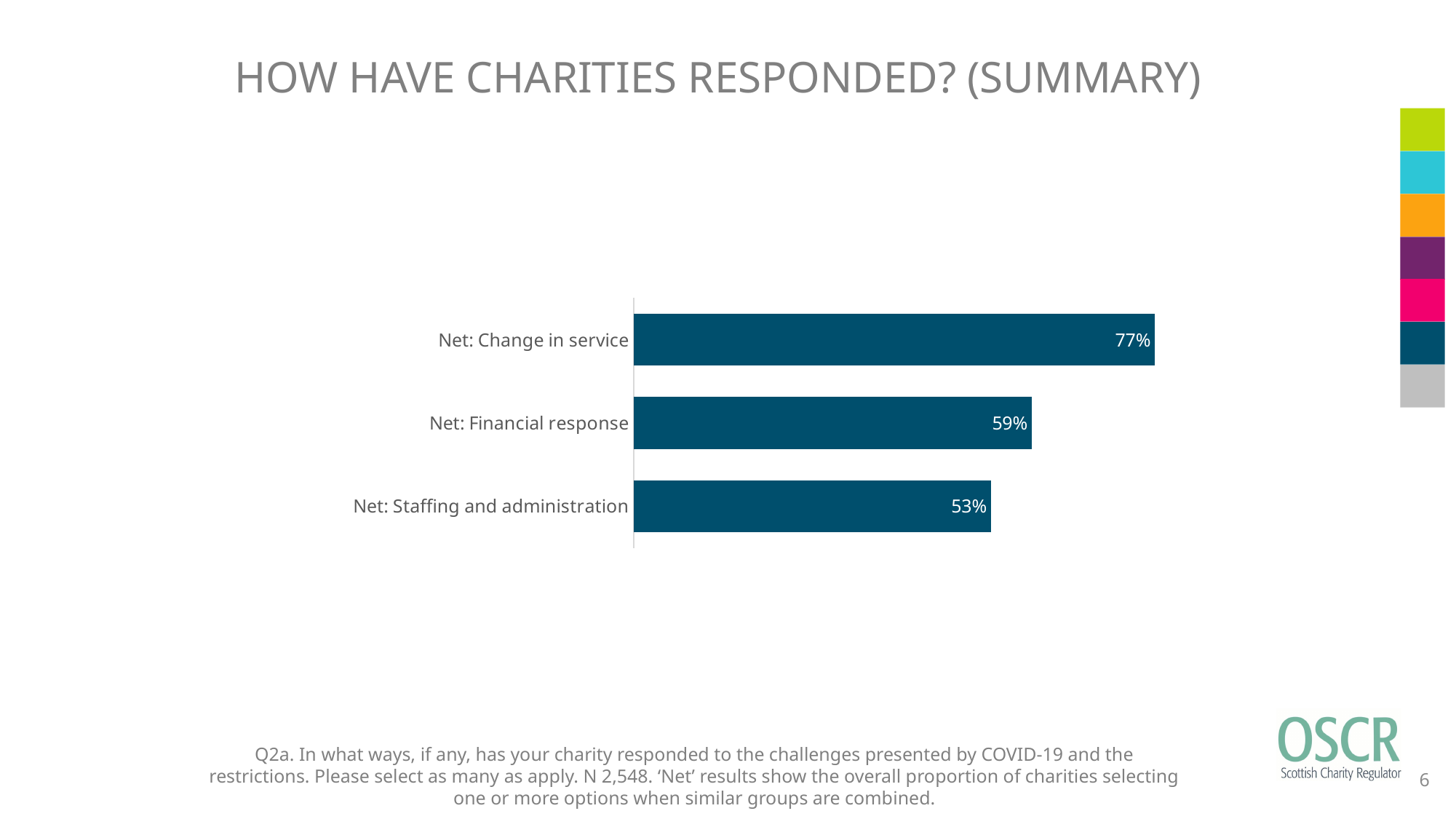
What is the difference between Net: Financial response and Net: Staffing and administration? 6% What is the title of the slide? HOW HAVE CHARITIES RESPONDED? (SUMMARY) What kind of chart is shown on the slide? Bar chart Which category has the lowest value? Net: Staffing and administration Which category has the highest value? Net: Change in service What is the value for Net: Staffing and administration? 53% Which is larger, Net: Financial response or Net: Staffing and administration? Net: Financial response What is the difference between Net: Change in service and Net: Financial response? 18% What is the value for Net: Change in service? 77% How many categories are shown in the chart? 3 What is the value for Net: Financial response? 59% What colour are the bars in the chart? Dark blue